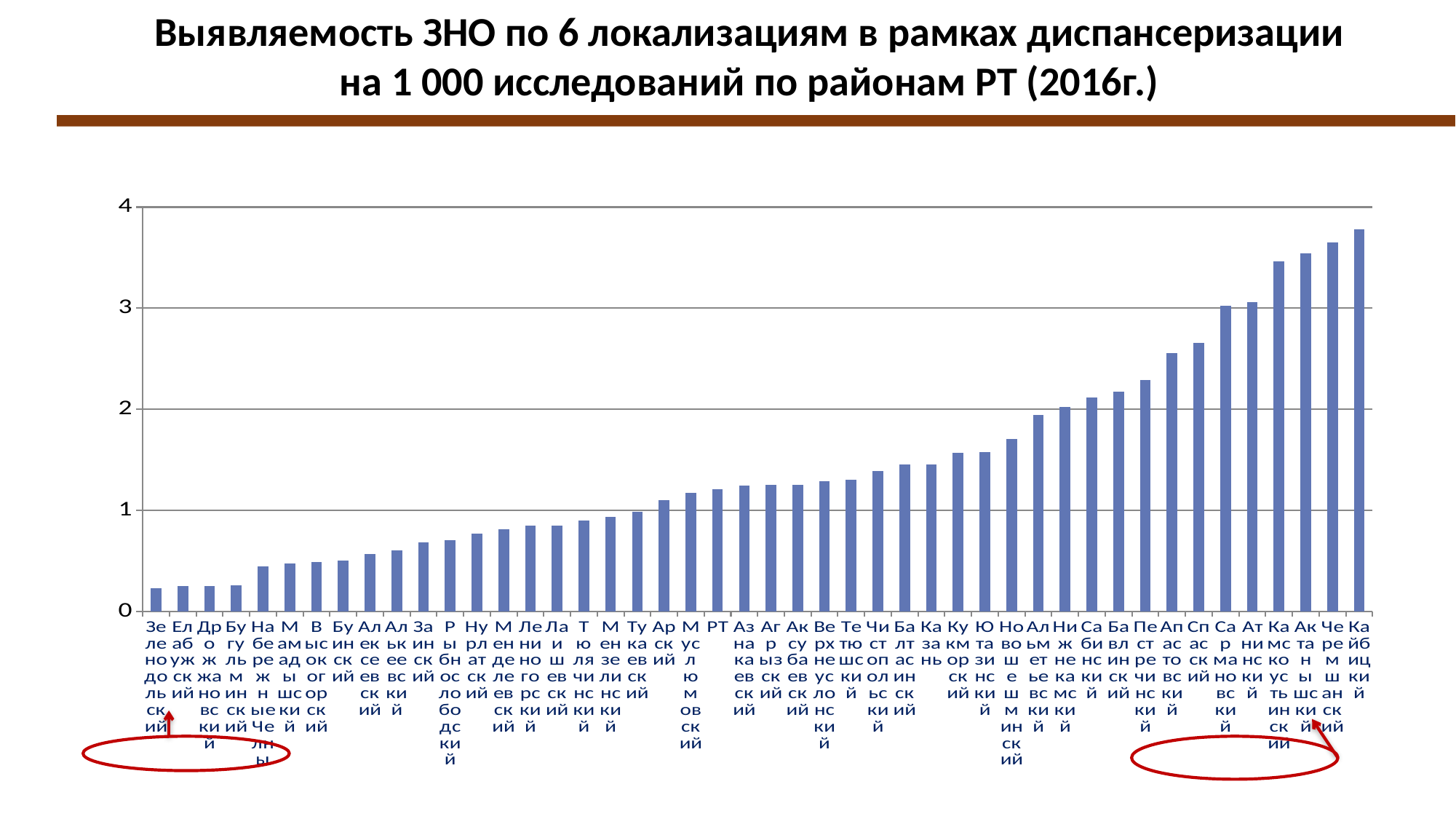
What year is given in the chart title? 2016 What kind of chart is shown on the slide? Bar chart Which has a higher value, Казань or РТ? Казань Is the value for Казань greater or less than 2? less Which district has the highest detection rate on the chart? Кайбицкий Is the value for Спасский greater or less than 2? greater Is the value for РТ greater or less than 1? greater Which district has the lowest detection rate on the chart? Зеленодольский Do the bar values rise or fall from left to right along the x axis? Rise